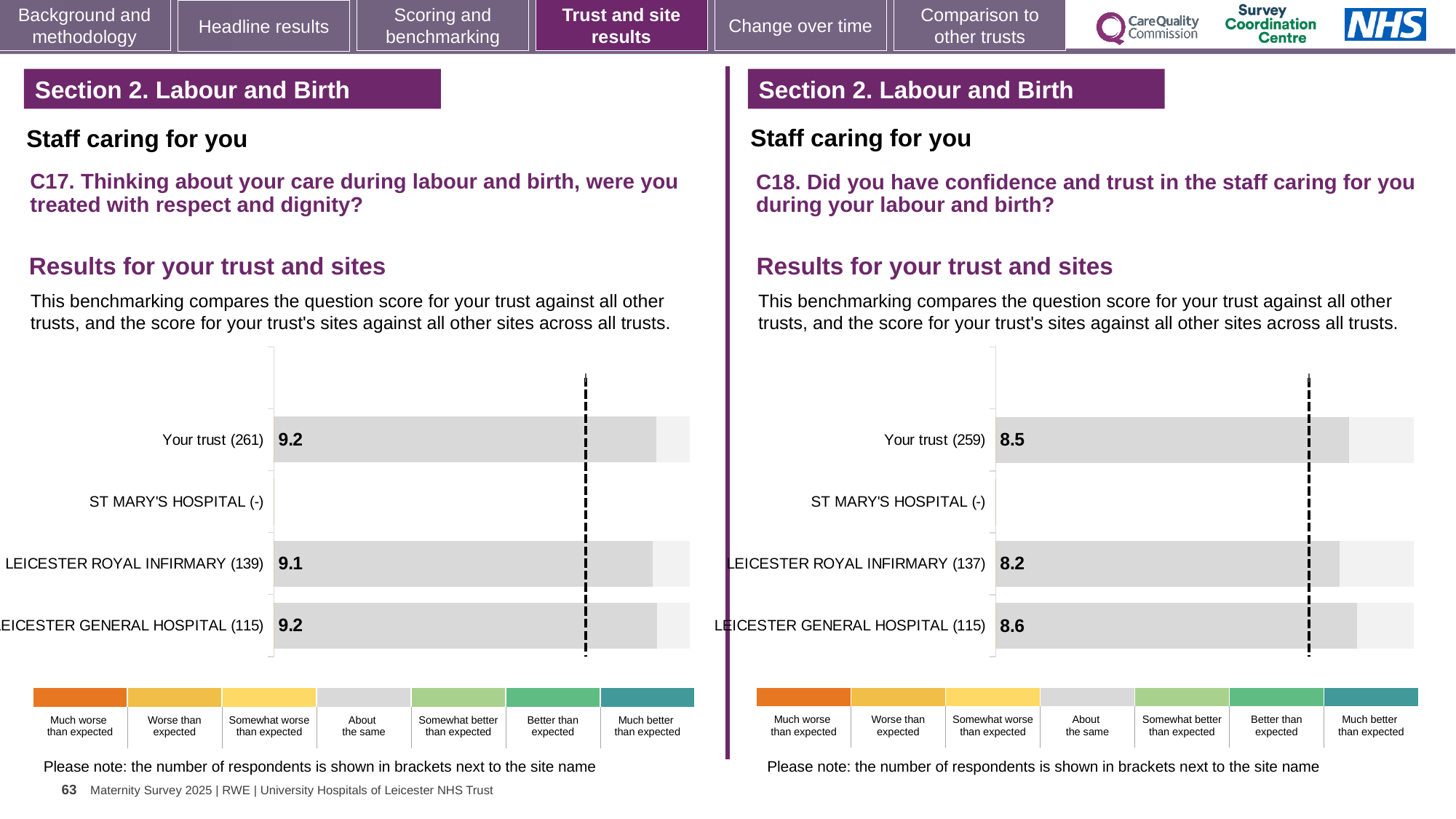
In the C18 chart on the right, which row has the highest score? LEICESTER GENERAL HOSPITAL (115) What kind of chart is used for the C18 results on the right? Bar chart In the C18 chart on the right, which is larger: the score for Your trust (259) or for LEICESTER ROYAL INFIRMARY (137)? Your trust (259) In the C17 chart on the left, what is the score for Your trust (261)? 9.2 In the C18 chart on the right, what is the score for Your trust (259)? 8.5 In the C17 chart on the left, what is the difference between the scores for Your trust (261) and LEICESTER ROYAL INFIRMARY (139)? 0.1 How many rows (categories) are listed in the C17 chart on the left? 4 In the C18 chart on the right, what is the score for LEICESTER GENERAL HOSPITAL (115)? 8.6 In the C18 chart on the right, what is the difference between the scores for LEICESTER GENERAL HOSPITAL (115) and LEICESTER ROYAL INFIRMARY (137)? 0.4 In the C17 chart on the left, what is the score for LEICESTER ROYAL INFIRMARY (139)? 9.1 In the C17 chart on the left, which row has the lowest score? LEICESTER ROYAL INFIRMARY (139) In the C18 chart on the right, which site has the lowest score? LEICESTER ROYAL INFIRMARY (137)